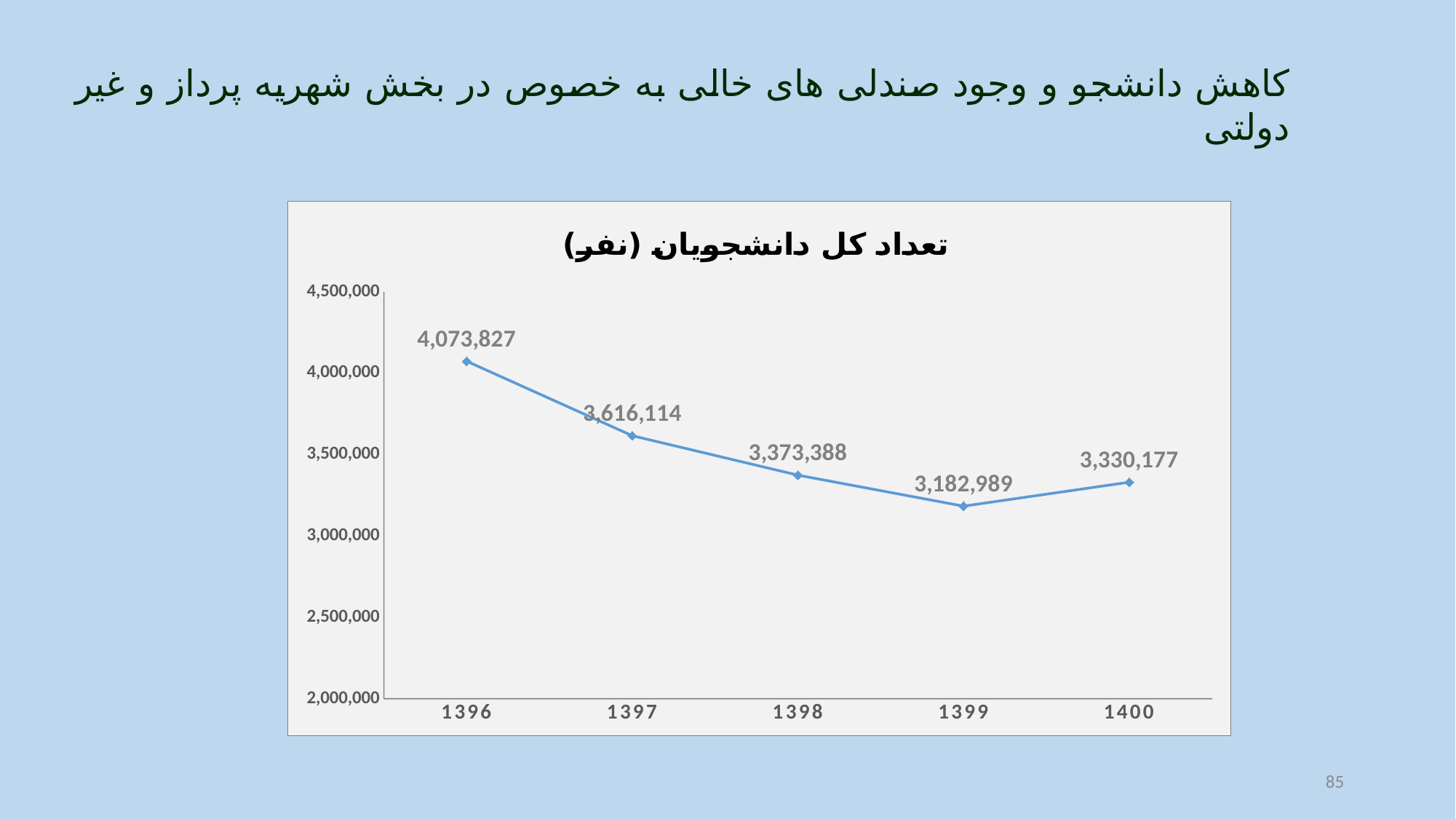
What is the value for 1400? 3,330,177 By how much does the value for 1400 exceed the value for 1399? 147,188 What is the total number of students shown for 1396? 4,073,827 Which year has the lowest value on the chart? 1399 Is the value for 1397 greater or less than 3,500,000? greater What value is plotted for 1399? 3,182,989 Which year has the highest value on the chart? 1396 Does the value rise or fall from 1396 to 1399? fall What kind of chart is shown on the slide? line chart How many years are plotted on the x axis? 5 Which year has the larger value, 1398 or 1400? 1398 What is the difference between the values for 1396 and 1397? 457,713